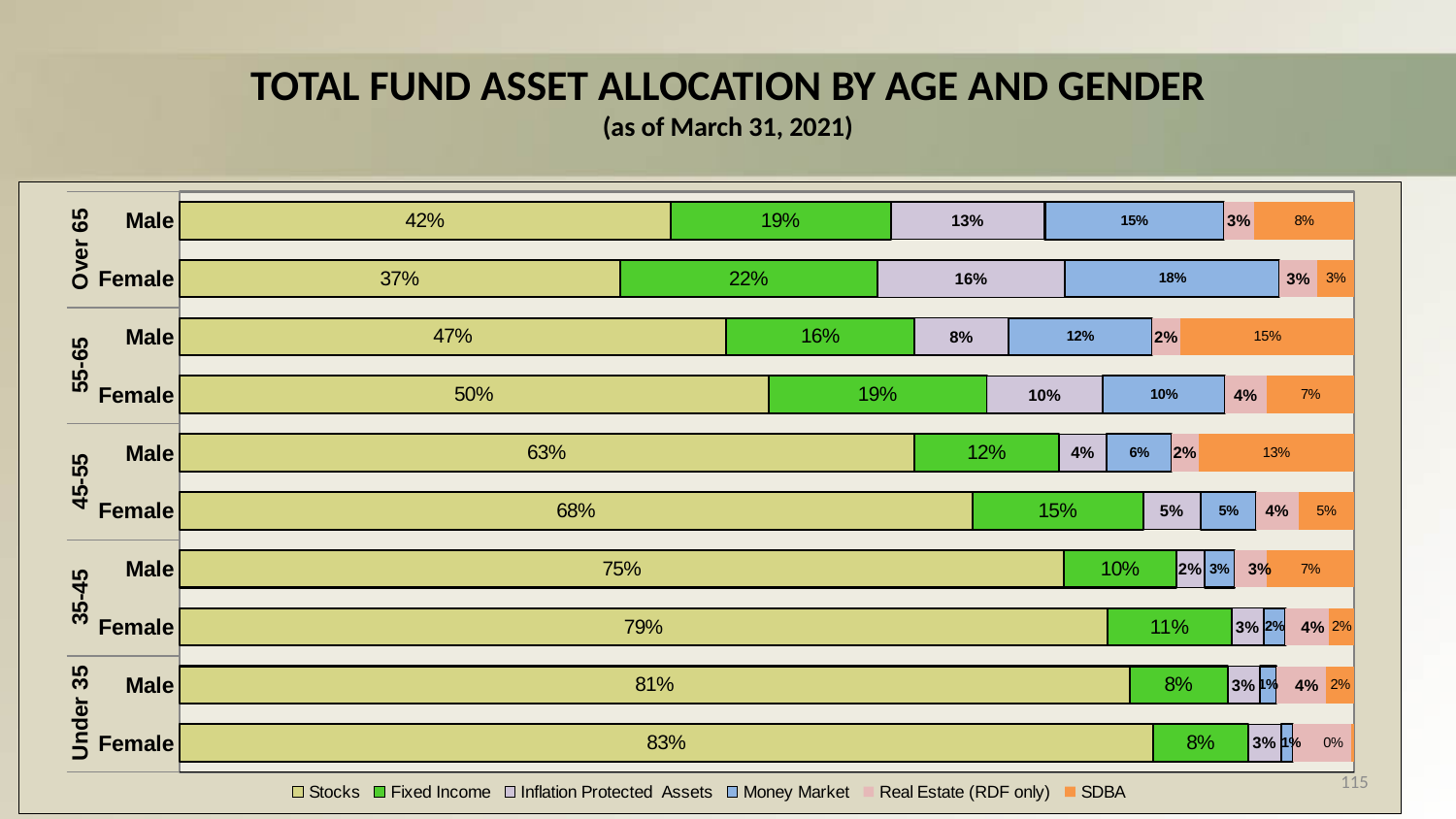
How many bars are shown in the chart? 10 What percentage of the Over 65 Male fund is allocated to Stocks? 42% What is the Fixed Income allocation for Over 65 Female? 22% How many series does the legend list? 6 What type of chart is shown on the slide? Stacked bar chart What is the total of the Over 65 Male stacked bar? 100% What is the SDBA allocation for 55-65 Male? 15% Which age and gender group has the highest Stocks allocation? Under 35 Female Which age and gender group has the lowest Stocks allocation? Over 65 Female Which has a larger Money Market allocation, Over 65 Male or Over 65 Female? Over 65 Female What is the Money Market allocation for 45-55 Male? 6% What is the difference between the Stocks allocation of 45-55 Female and 45-55 Male? 5%